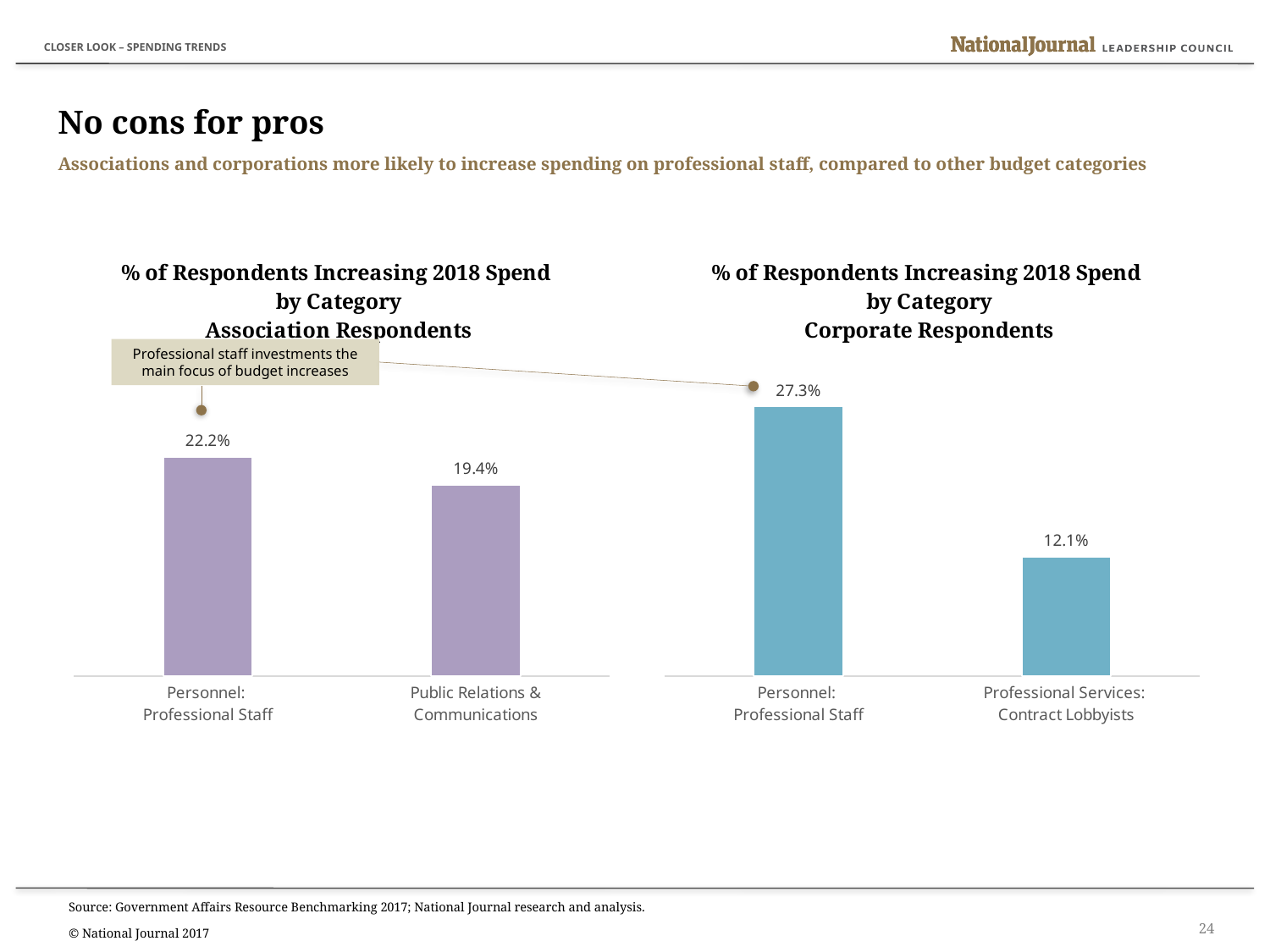
In the Corporate Respondents chart, what is the difference between Personnel: Professional Staff and Professional Services: Contract Lobbyists? 15.2% In the Corporate Respondents chart, which category has the lowest value? Professional Services: Contract Lobbyists What type of chart is the Association Respondents chart? Bar chart In the Corporate Respondents chart, what is the value for Professional Services: Contract Lobbyists? 12.1% How many categories are shown in the Corporate Respondents chart? 2 In the Association Respondents chart, what is the difference between Personnel: Professional Staff and Public Relations & Communications? 2.8% What does the callout box on the left chart say? Professional staff investments the main focus of budget increases In the Corporate Respondents chart, what is the value for Personnel: Professional Staff? 27.3% In the Association Respondents chart, which category has the highest value? Personnel: Professional Staff Which is larger: the Personnel: Professional Staff value in the Association Respondents chart or in the Corporate Respondents chart? Corporate Respondents In the Association Respondents chart, what is the value for Public Relations & Communications? 19.4% In the Association Respondents chart, what percentage of respondents are increasing 2018 spend on Personnel: Professional Staff? 22.2%